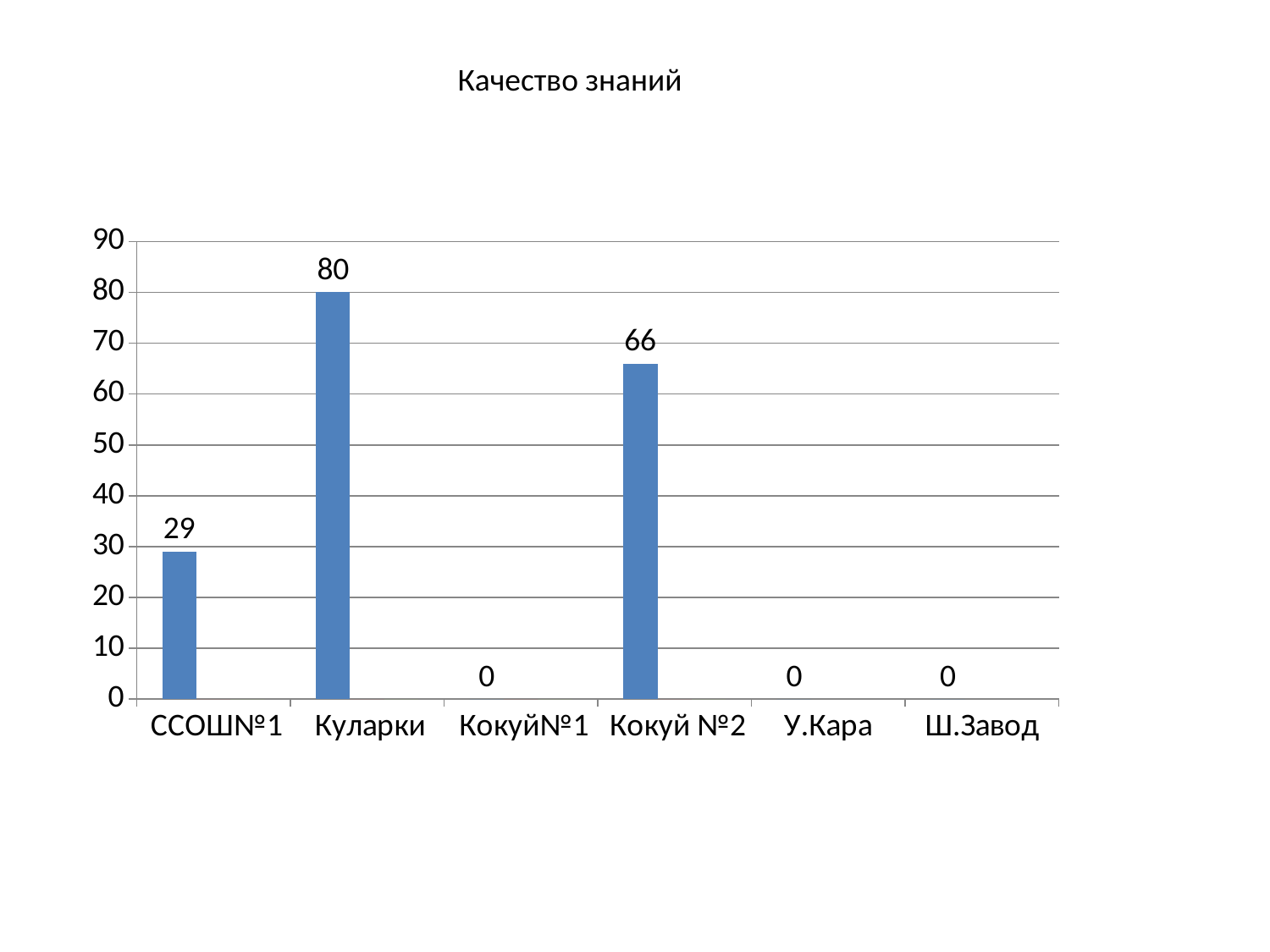
What is the difference between the values for Кокуй №2 and ССОШ№1? 37 What is the value for Куларки? 80 What is the value for У.Кара? 0 Which category has the highest value? Куларки What kind of chart is this? bar chart Which is larger, the value for ССОШ№1 or the value for Кокуй №2? Кокуй №2 What is the value for Кокуй №2? 66 How many categories are shown on the x axis? 6 What is the title of the chart? Качество знаний How many categories have a value of 0? 3 What is the difference between the values for Куларки and Кокуй №2? 14 What is the value for ССОШ№1? 29